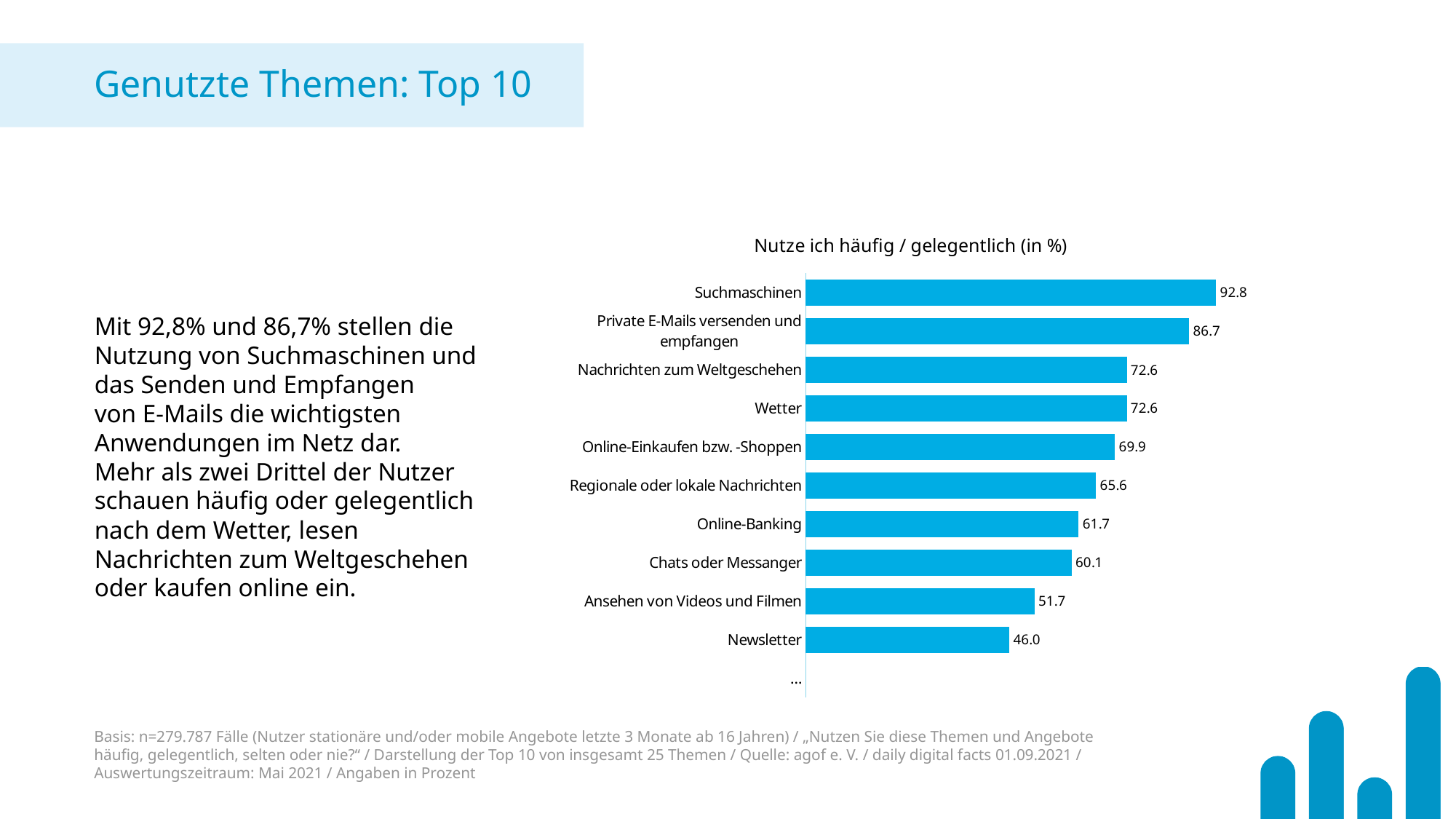
Which category has the lowest value? Newsletter What is the value for Suchmaschinen? 92.8 What is the difference between the values for Online-Einkaufen bzw. -Shoppen and Chats oder Messanger? 9.8 How many bars are plotted in the chart? 10 What is the difference between the values for Suchmaschinen and Private E-Mails versenden und empfangen? 6.1 What is the title of the chart? Nutze ich häufig / gelegentlich (in %) What is the value for Newsletter? 46.0 What kind of chart is shown on the slide? Bar chart What is the value for Online-Banking? 61.7 Which category has the highest value? Suchmaschinen What is the value for Ansehen von Videos und Filmen? 51.7 Which is larger, the value for Regionale oder lokale Nachrichten or the value for Online-Banking? Regionale oder lokale Nachrichten